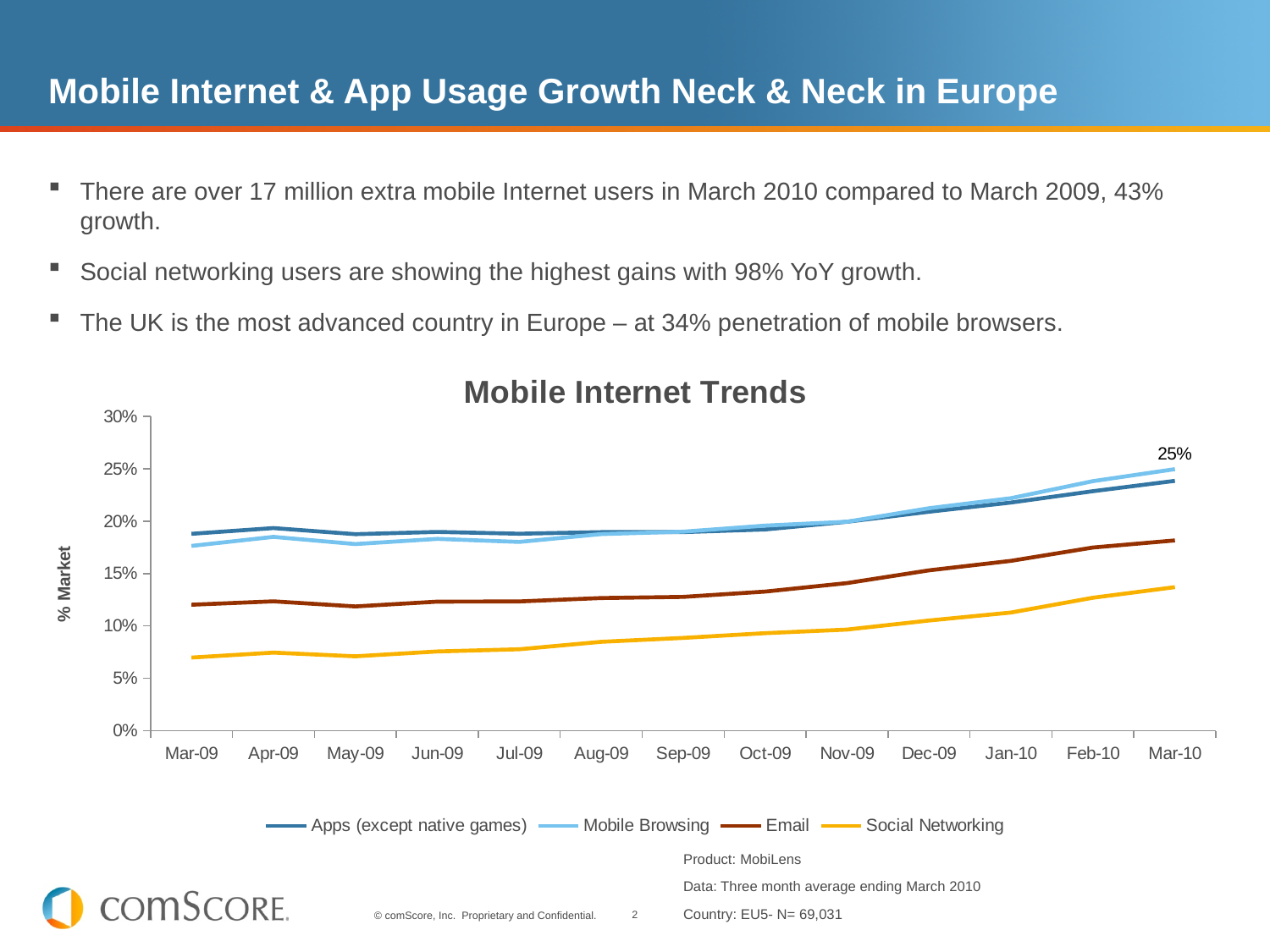
What is the value for Mobile Browsing in Mar-10? 25% What kind of chart is shown on the slide? line chart What is the label on the vertical axis of the chart? % Market How many months are shown along the x axis of the Mobile Internet Trends chart? 13 Is the value for Email in Mar-10 greater or less than 15%? greater Does the Social Networking line rise or fall from Mar-09 to Mar-10? rise Is the value for Social Networking in Mar-10 greater or less than 10%? greater Is the value for Social Networking in Mar-09 greater or less than 10%? less How many series does the legend of the Mobile Internet Trends chart list? 4 Which series has the lowest value in Mar-10? Social Networking Which is larger in Mar-10, Email or Social Networking? Email